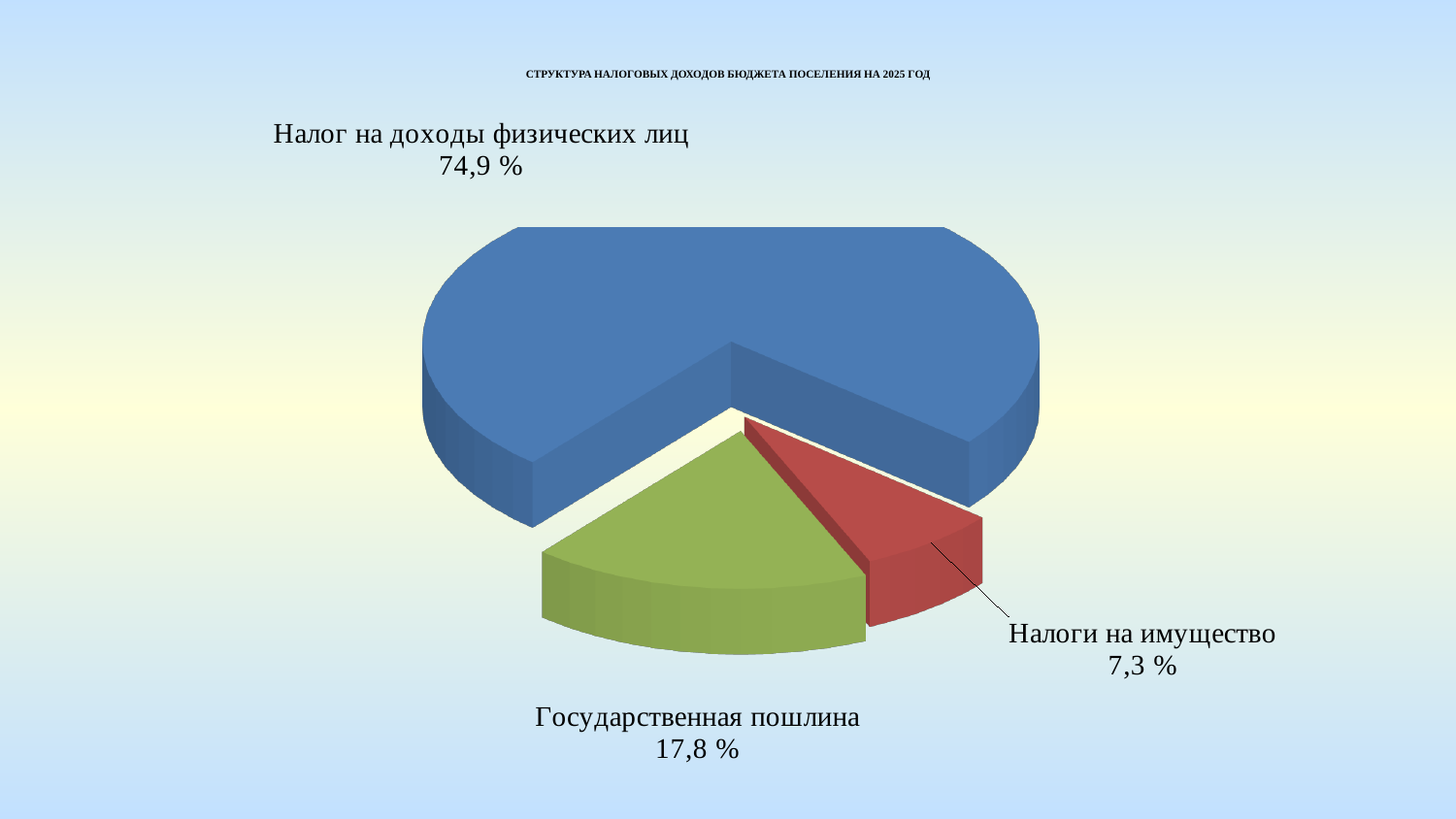
Какова доля государственной пошлины? 17,8 % На сколько процентных пунктов доля налога на доходы физических лиц больше доли государственной пошлины? 57,1 На сколько процентных пунктов доля государственной пошлины больше доли налогов на имущество? 10,5 Каким цветом показан сектор «Государственная пошлина»? Зелёным Какая категория имеет наибольшую долю в структуре налоговых доходов? Налог на доходы физических лиц Что больше: доля государственной пошлины или доля налогов на имущество? Государственная пошлина Какова доля налогов на имущество? 7,3 % Какой тип диаграммы показан на слайде? Круговая диаграмма Сколько категорий показано на круговой диаграмме? 3 Какова доля налога на доходы физических лиц в структуре налоговых доходов? 74,9 % Какая категория имеет наименьшую долю? Налоги на имущество Как называется диаграмма на слайде? Структура налоговых доходов бюджета поселения на 2025 год